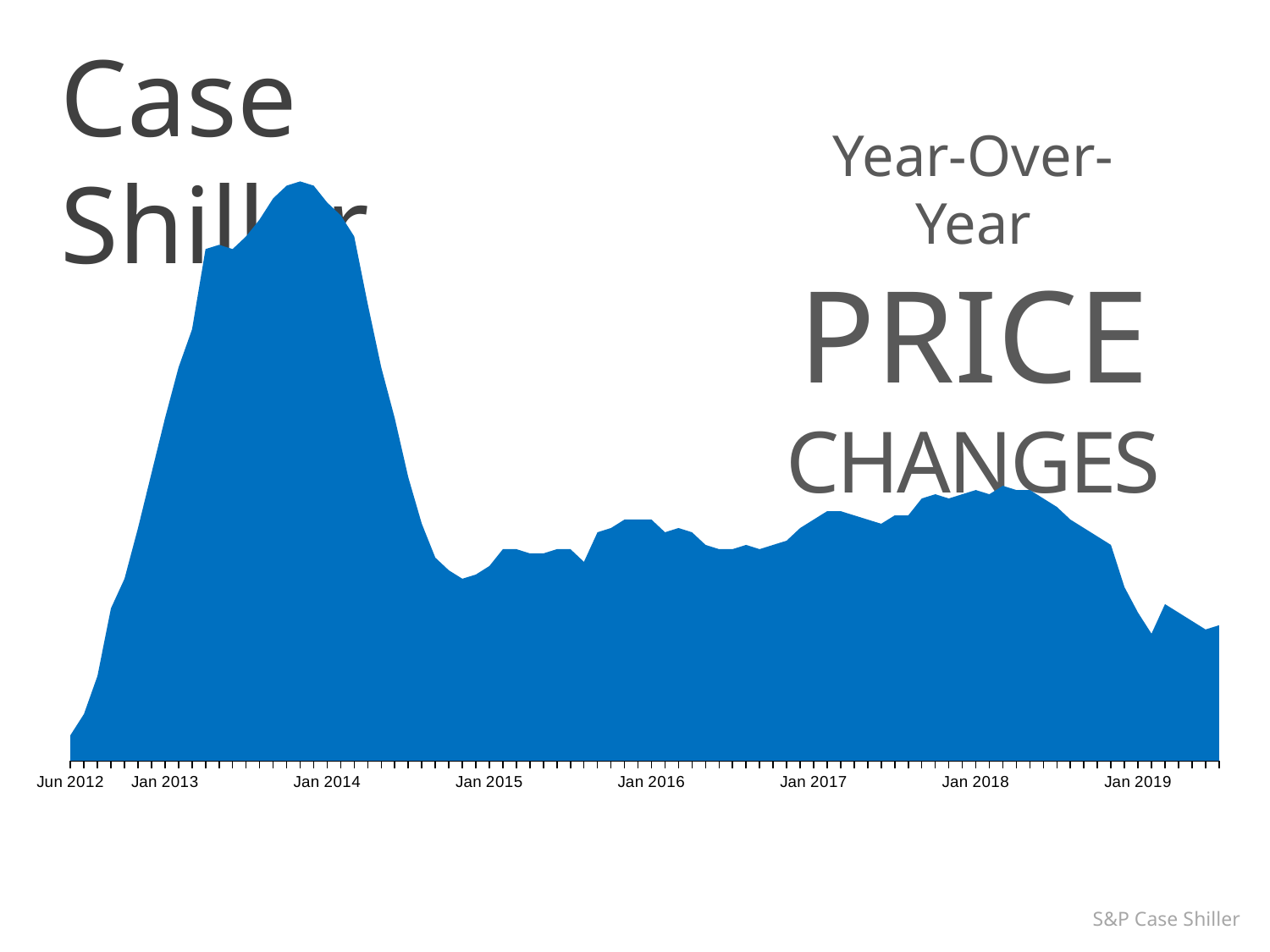
What is the first date label on the x axis? Jun 2012 What kind of chart is shown on the slide? area chart What is the title of the chart? Case Shiller Year-Over-Year PRICE CHANGES What source is cited for the chart? S&P Case Shiller Around which x-axis label does the chart reach its highest value? Jan 2014 How many date labels are shown on the x axis? 8 Do the values rise or fall from Jan 2018 to Jan 2019? fall Which is higher, the value at Jan 2014 or the value at Jan 2019? Jan 2014 Do the values rise or fall from Jun 2012 to Jan 2014? rise Do the values rise or fall from Jan 2014 to Jan 2015? fall What is the last date label on the x axis? Jan 2019 At which x-axis label is the chart at its lowest value? Jun 2012